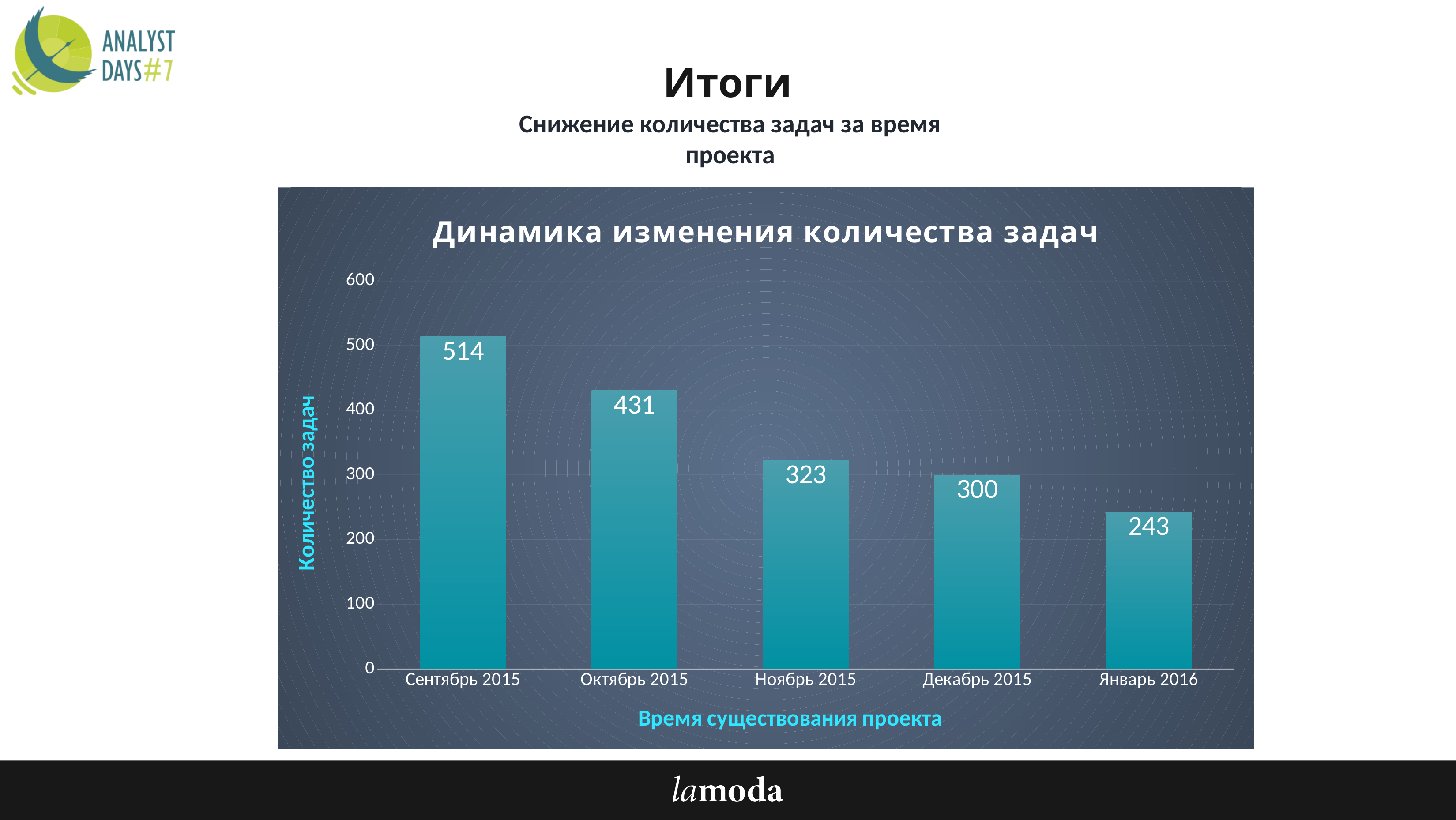
What kind of chart is shown on the slide? bar chart What is the value for Ноябрь 2015? 323 What is the value for Сентябрь 2015? 514 How many months are shown on the x axis? 5 What is the difference between the values for Сентябрь 2015 and Октябрь 2015? 83 Do the values rise or fall from Сентябрь 2015 to Январь 2016? fall What is the difference between the values for Декабрь 2015 and Январь 2016? 57 Which month has the highest number of tasks? Сентябрь 2015 Which is larger, the value for Октябрь 2015 or the value for Ноябрь 2015? Октябрь 2015 Is the value for Декабрь 2015 greater or less than 400? less What is the value for Январь 2016? 243 Which month has the lowest number of tasks? Январь 2016